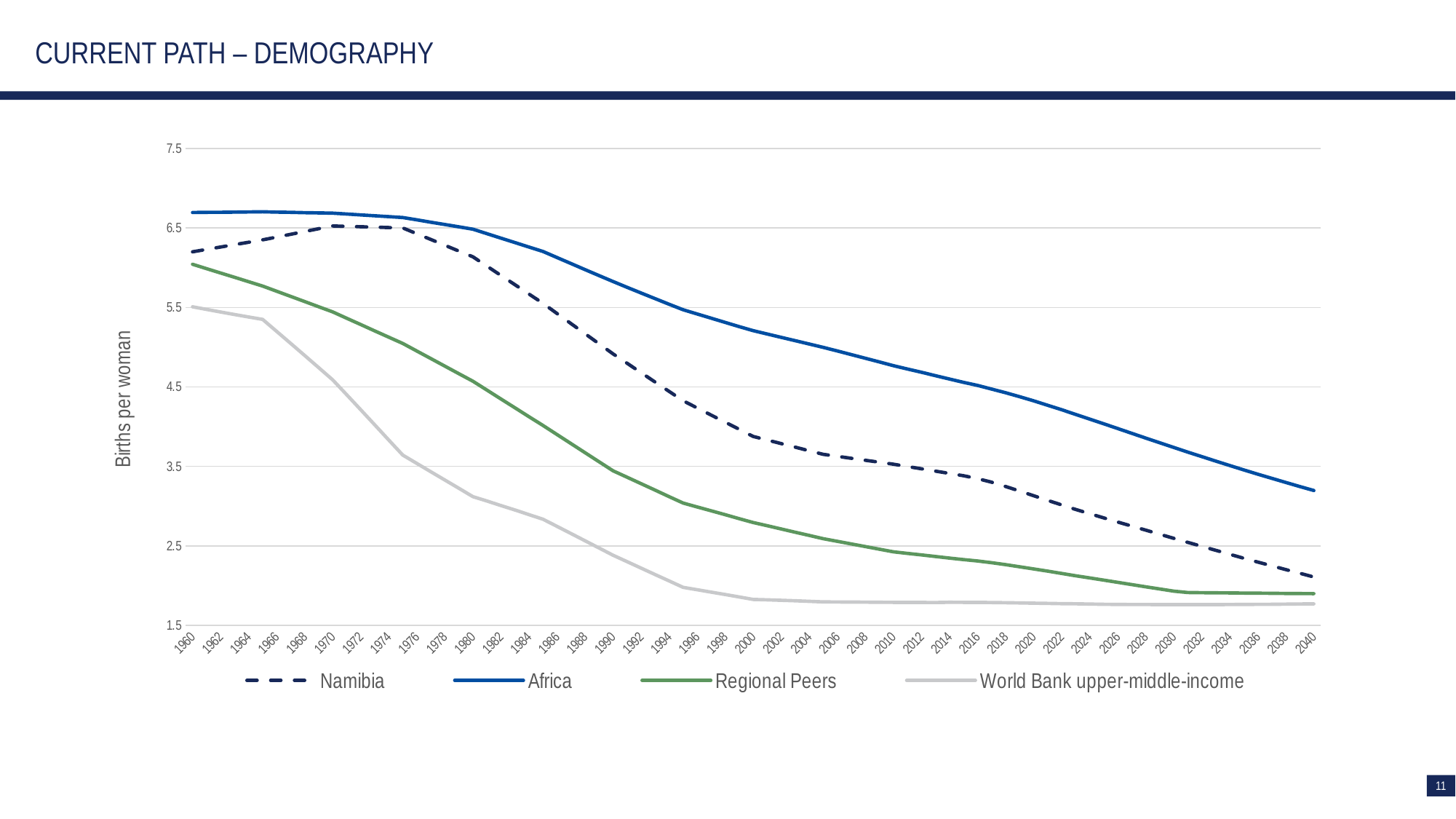
What is the title of the slide? CURRENT PATH – DEMOGRAPHY How many series does the legend list? 4 What kind of chart is shown on the slide? line chart Do the values for World Bank upper-middle-income rise or fall from 1960 to 2040? fall What is the label on the vertical axis? Births per woman Which series has the highest value in 1960? Africa In 1990, which is larger: the value for Namibia or the value for Regional Peers? Namibia Do the values for Africa rise or fall from 1960 to 2040? fall Is the value for Africa in 2040 greater or less than 2.5? greater Which series has the lowest value in 2040? World Bank upper-middle-income Which series has the highest value in 2040? Africa Is the value for Namibia in 2040 greater or less than 2.5? less